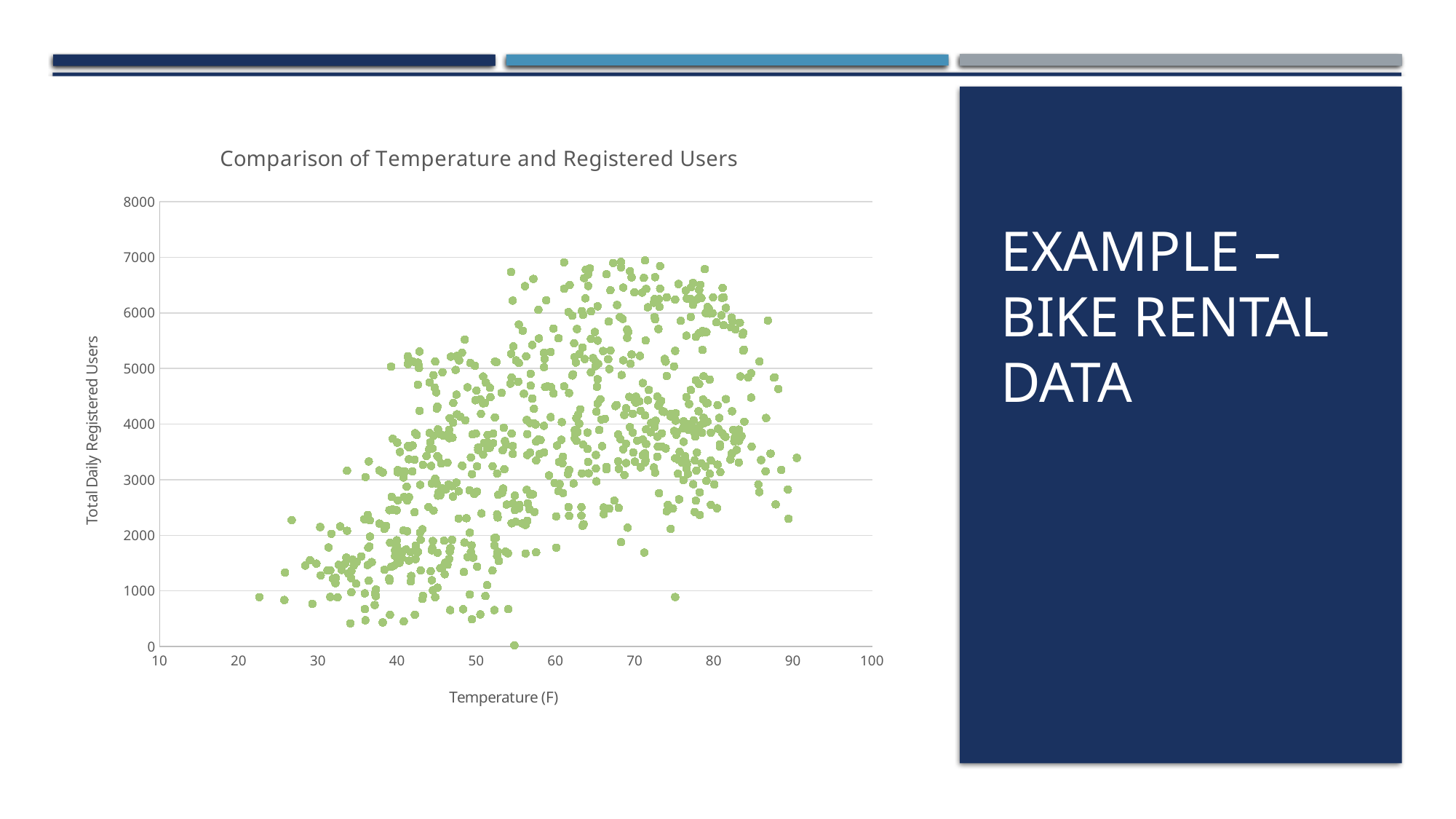
What is the maximum value shown on the y axis? 8000 Is the highest temperature plotted greater or less than 100? less What is the title of the chart? Comparison of Temperature and Registered Users What is the minimum value shown on the x axis? 10 Is the lowest value of Total Daily Registered Users greater or less than 1000? less What kind of chart is shown on the slide? scatter plot What is the label of the x axis? Temperature (F) Is the highest value of Total Daily Registered Users greater or less than 8000? less Do the registered user values generally rise or fall as temperature increases along the x axis? rise